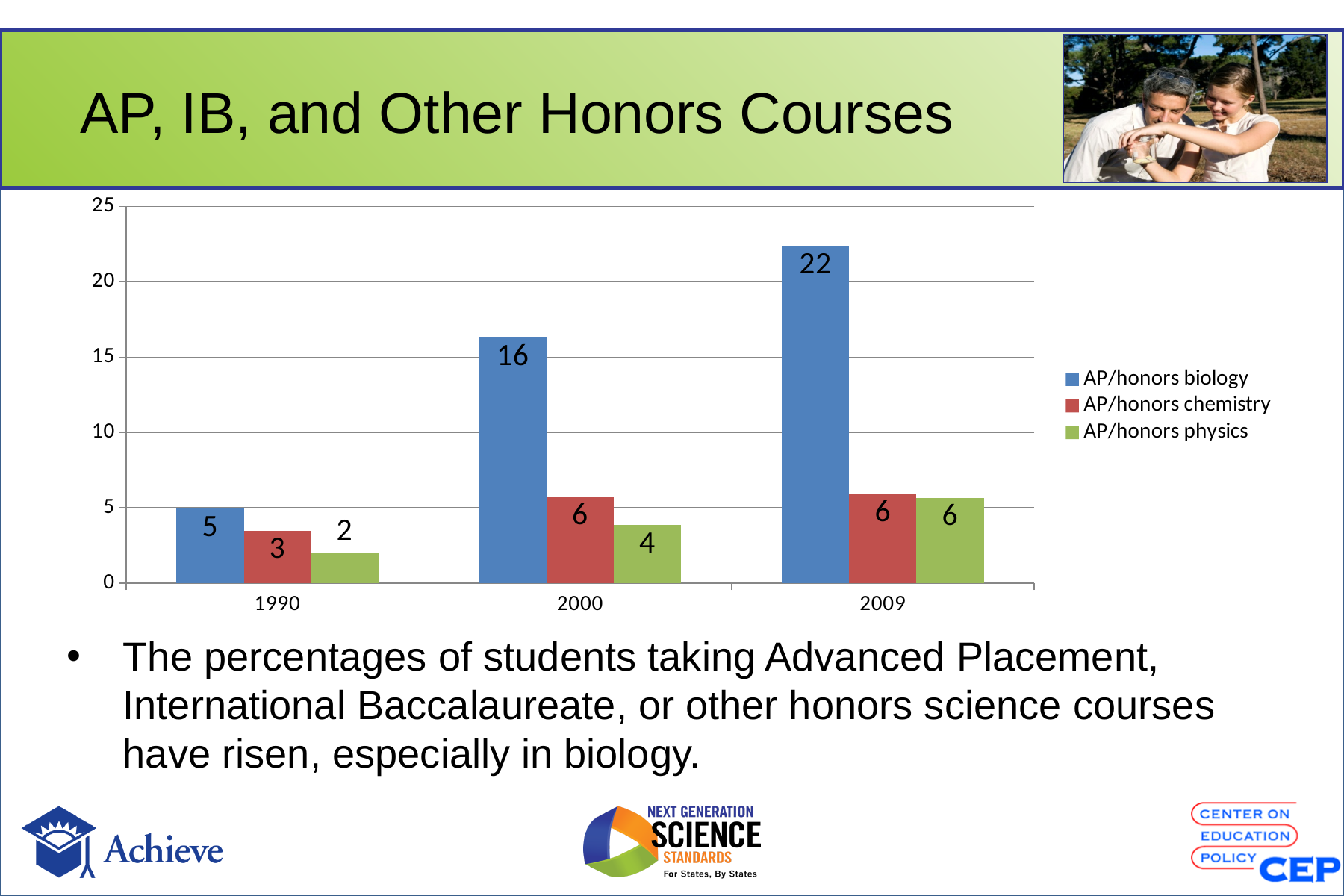
What is the value for AP/honors physics in 1990? 2 How many years are shown on the x axis? 3 What is the value for AP/honors chemistry in 2000? 6 In which year is the AP/honors physics value lowest? 1990 How many series does the legend list? 3 What is the difference between the AP/honors biology values for 2009 and 1990? 17 What is the value for AP/honors biology in 2009? 22 Which is larger in 2000: AP/honors chemistry or AP/honors physics? AP/honors chemistry What kind of chart is shown on the slide? bar chart Does the AP/honors biology value rise or fall from 1990 to 2009? rise In which year is the AP/honors biology value highest? 2009 Is the value for AP/honors biology in 2000 greater or less than 15? greater